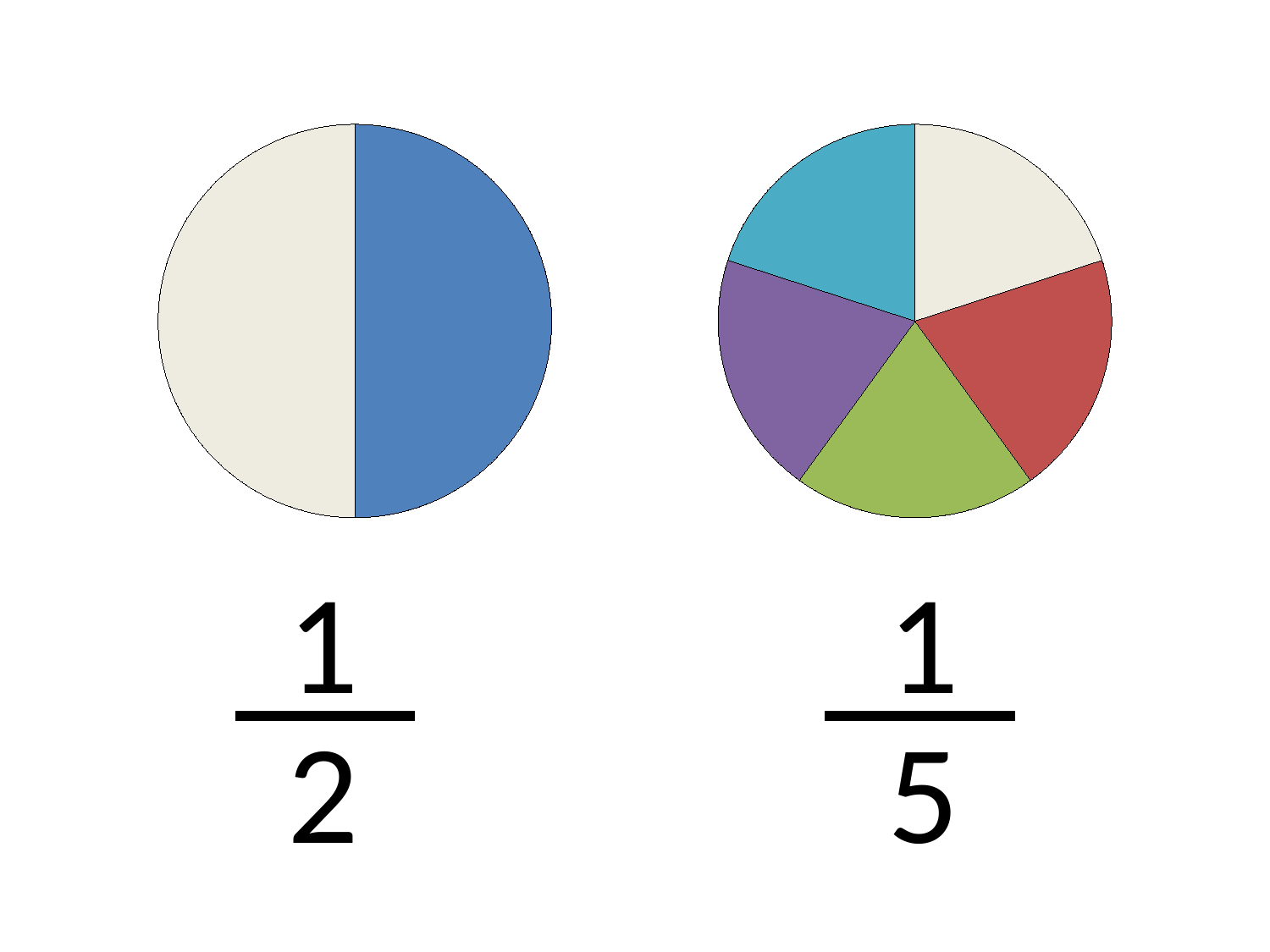
Which is larger: the blue slice in the pie chart on the left of the slide or the purple slice in the pie chart on the right of the slide? the blue slice in the left pie chart What kind of chart is the chart on the right of the slide? pie chart In the pie chart on the right of the slide, what share of the pie does the red slice represent? 1/5 How many slices does the pie chart on the right of the slide have? 5 In the pie chart on the left of the slide, what share of the pie does the blue slice represent? 1/2 What fraction is printed below the pie chart on the right of the slide? 1/5 In the pie chart on the right of the slide, what share of the pie does the green slice represent? 1/5 What fraction is printed below the pie chart on the left of the slide? 1/2 What kind of chart is the chart on the left of the slide? pie chart How many slices does the pie chart on the left of the slide have? 2